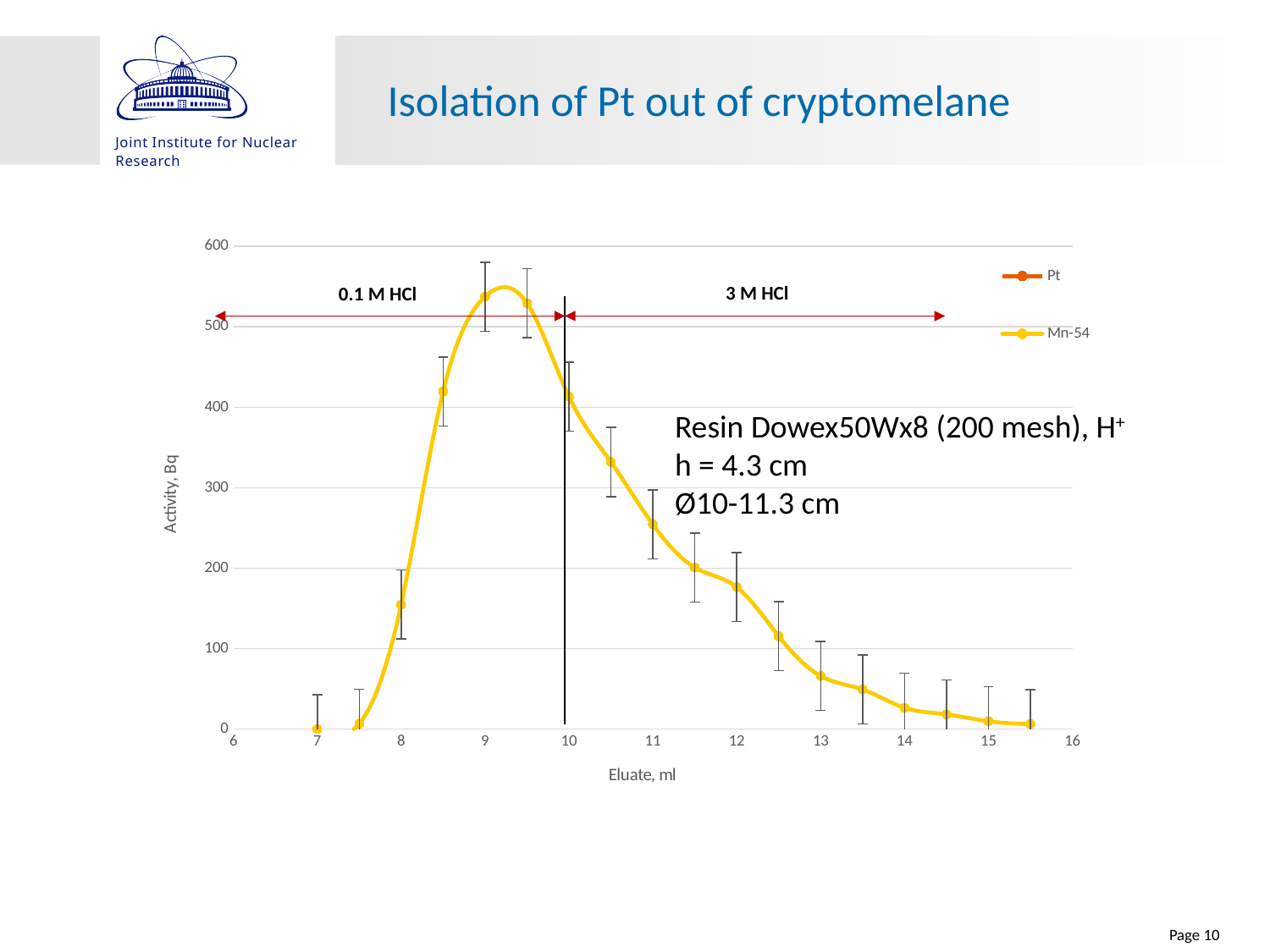
Is the Mn-54 value at 8 ml eluate greater or less than 200? less What is the label of the y axis? Activity, Bq How many series does the legend list? 2 What kind of chart is shown on the slide? line chart Is the Mn-54 value at 11 ml eluate greater or less than 300? less Is the Mn-54 value at 13 ml eluate greater or less than 100? less What are the two series named in the legend? Pt and Mn-54 Which is larger, the Mn-54 value at 10.5 ml or at 12 ml eluate? 10.5 ml Do the Mn-54 values rise or fall between 10 ml and 15.5 ml eluate? fall Which is larger, the Mn-54 value at 8 ml or at 8.5 ml eluate? 8.5 ml